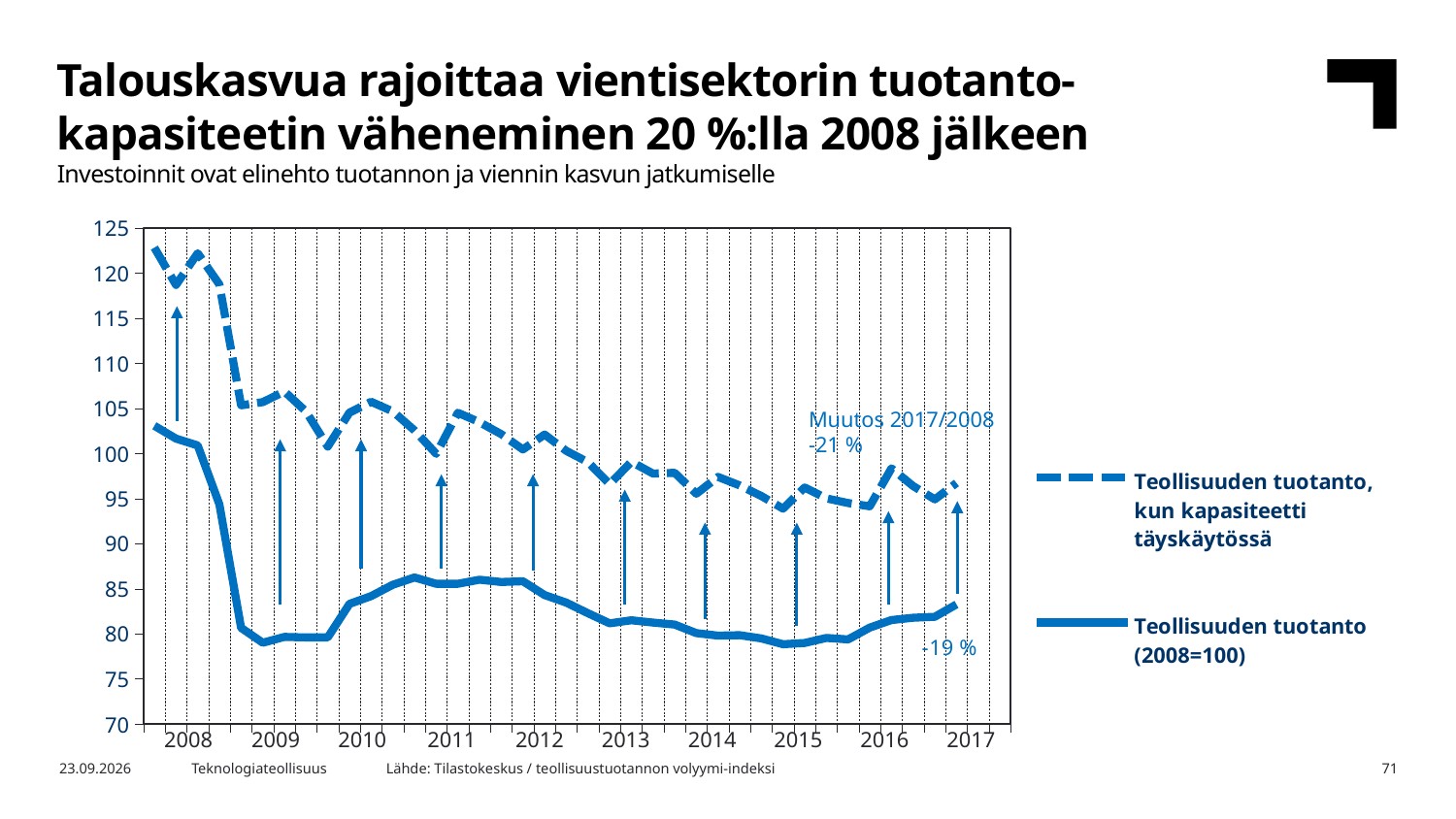
Which series is drawn as a dashed line? Teollisuuden tuotanto, kun kapasiteetti täyskäytössä Which series is higher in 2012, the dashed line (kapasiteetti täyskäytössä) or the solid line (2008=100)? the dashed line (kapasiteetti täyskäytössä) What percentage change is printed next to the solid line, Teollisuuden tuotanto (2008=100), at the end of the series? -19 % How many series does the legend list? 2 Is the value of the dashed line Teollisuuden tuotanto kun kapasiteetti täyskäytössä in 2017 greater or less than 90? greater How many years are labelled on the x axis? 10 What kind of chart is shown on the slide? line chart Is the value of the solid line Teollisuuden tuotanto (2008=100) in 2009 greater or less than 85? less Is the value of the dashed line Teollisuuden tuotanto kun kapasiteetti täyskäytössä at the start of 2008 greater or less than 115? greater Does the solid line Teollisuuden tuotanto (2008=100) overall rise or fall from 2008 to 2017? fall What is the change 2017/2008 (Muutos 2017/2008) shown for the dashed line, Teollisuuden tuotanto kun kapasiteetti täyskäytössä? -21 % What is the lowest value shown on the y axis? 70